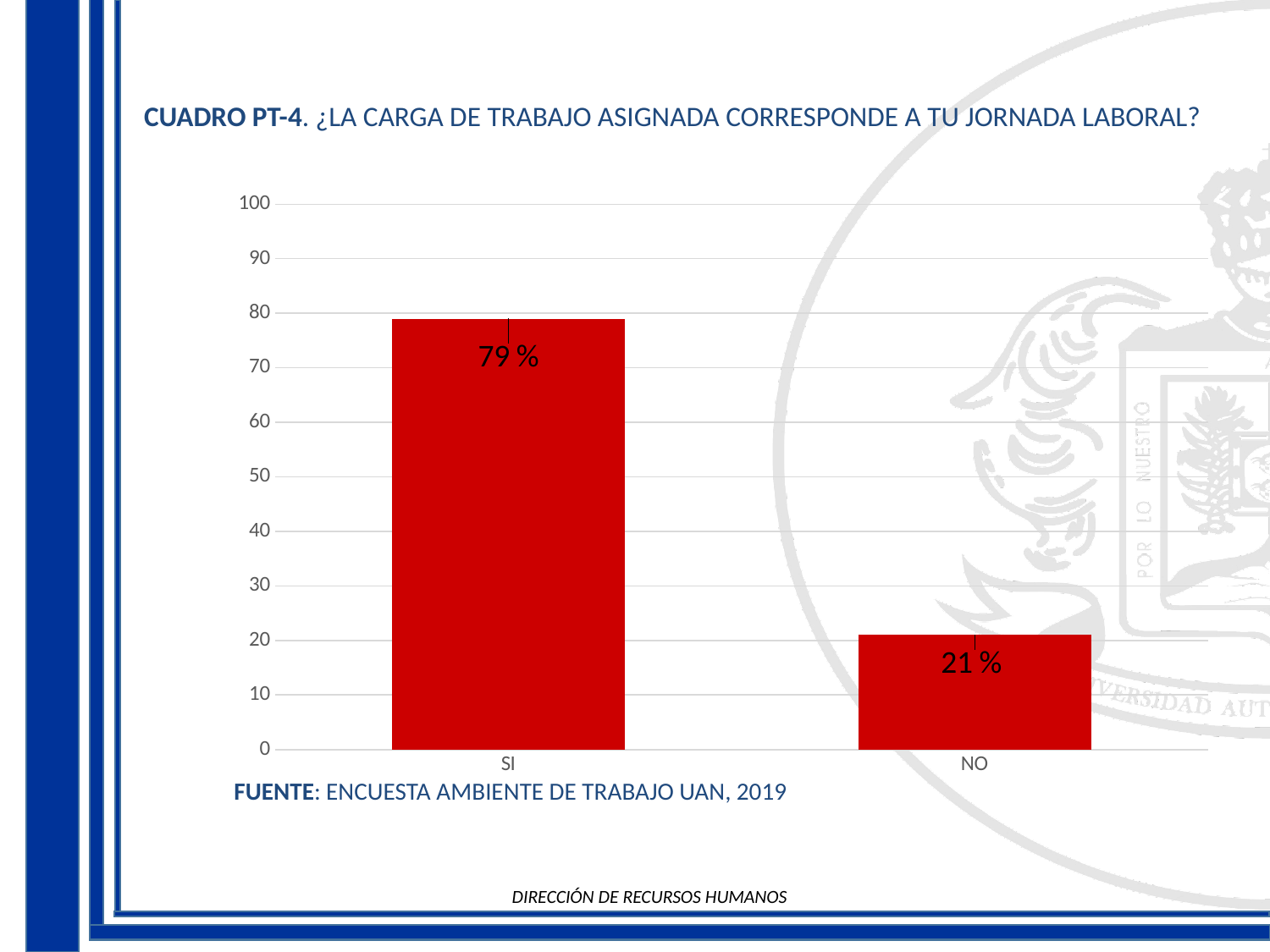
Which is larger, the value for SI or the value for NO? SI What colour are the bars in the chart? red How many categories are shown on the x axis? 2 What kind of chart is shown on the slide? bar chart What is the source cited below the chart? ENCUESTA AMBIENTE DE TRABAJO UAN, 2019 What is the difference between the values for SI and NO? 58 % Which category has the lowest value? NO Is the value for NO greater or less than 30? less Is the value for SI greater or less than 70? greater What is the value for SI? 79 % What is the value for NO? 21 % Which category has the highest value? SI